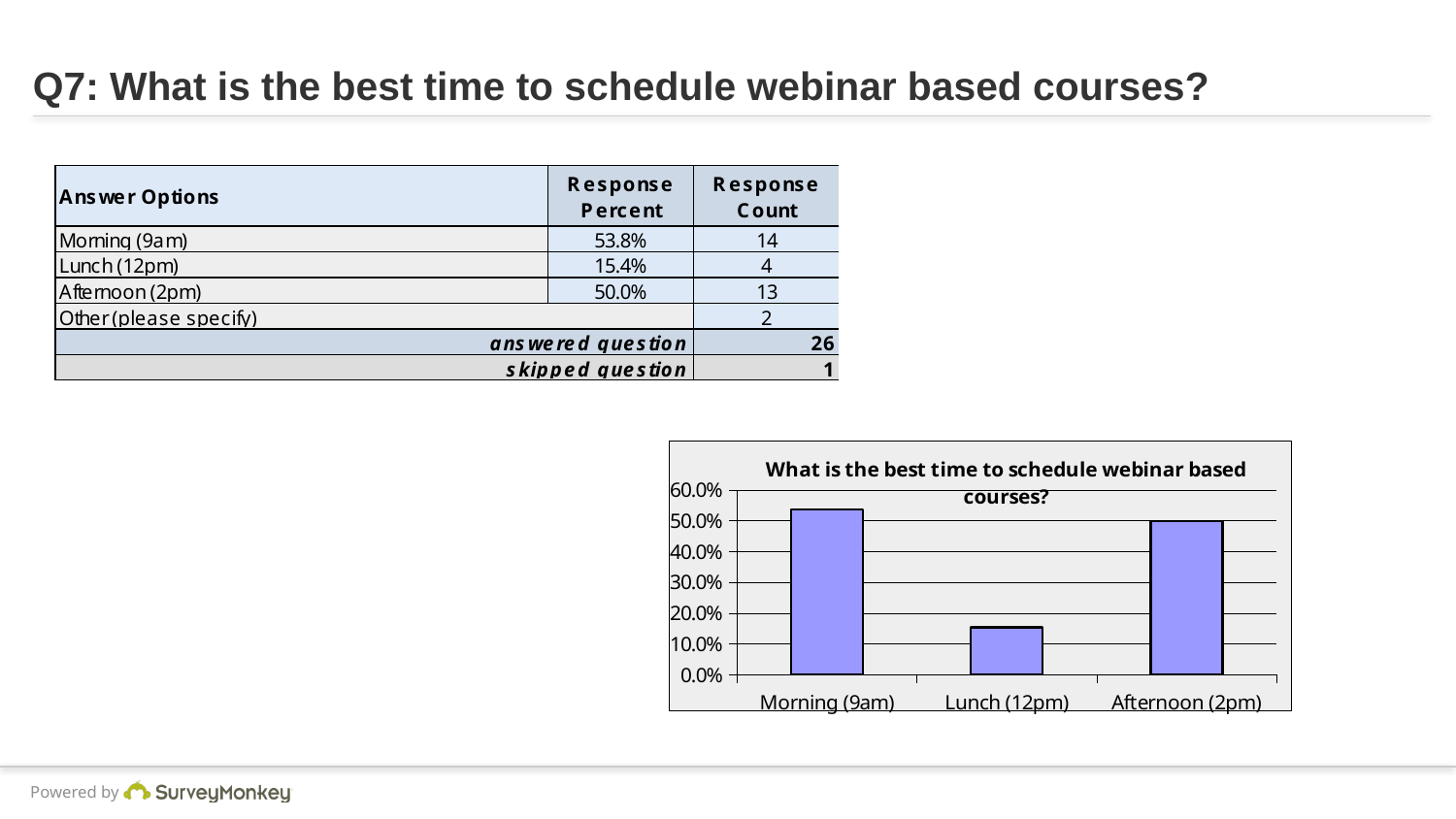
What is the difference between the response percent for Morning (9am) and Lunch (12pm)? 38.4% What type of chart is shown on the slide? bar chart Which is larger, the value for Lunch (12pm) or the value for Afternoon (2pm)? Afternoon (2pm) Is the value for Lunch (12pm) greater or less than 20.0%? less What is the response percent for Morning (9am)? 53.8% What is the response percent for Afternoon (2pm)? 50.0% What is the title of the chart? What is the best time to schedule webinar based courses? What is the response percent for Lunch (12pm)? 15.4% Which category has the highest value in the chart? Morning (9am) How many categories are plotted in the chart? 3 Is the value for Morning (9am) greater or less than 50.0%? greater Which category has the lowest value in the chart? Lunch (12pm)